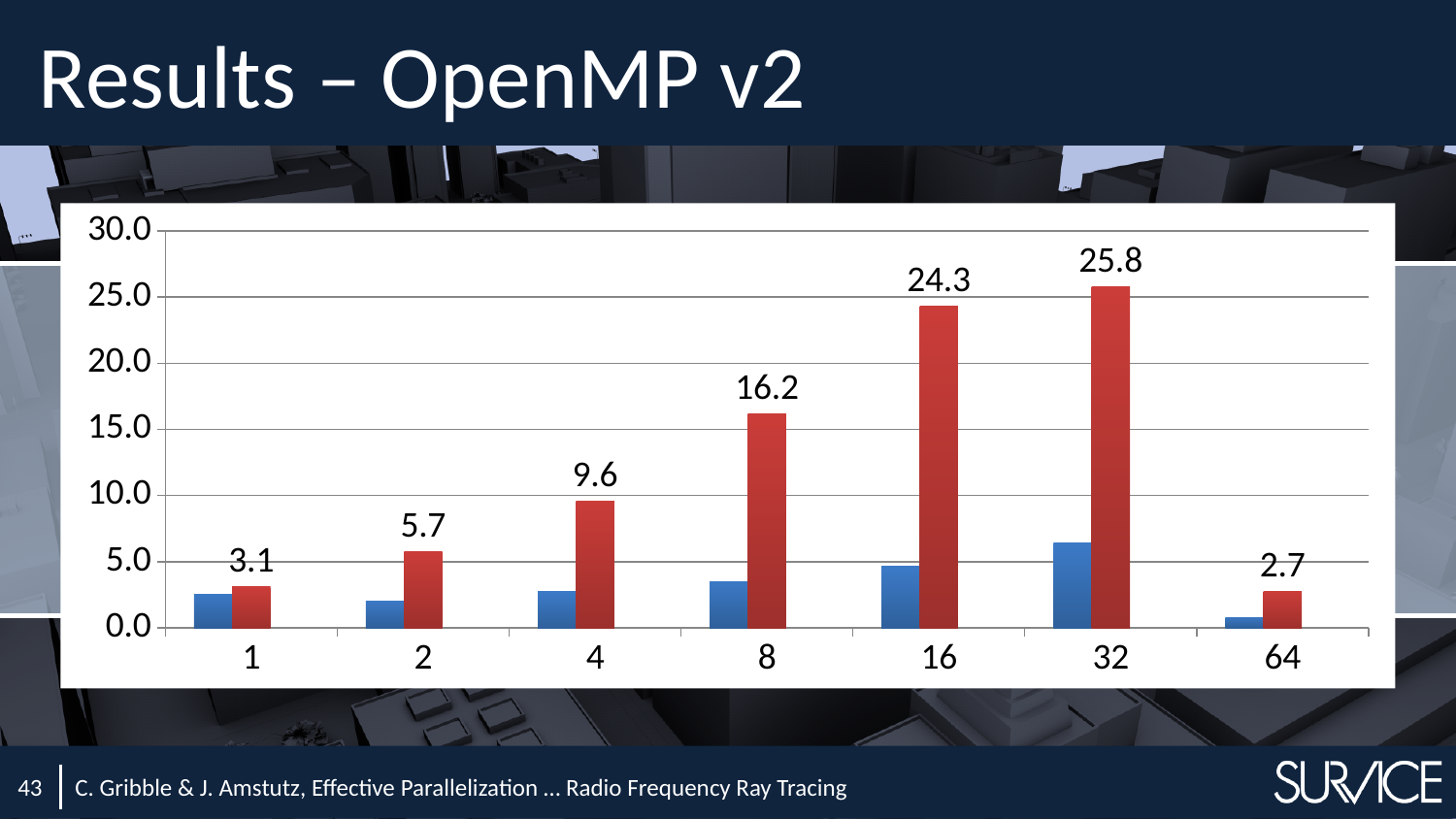
Is the value of the blue bar for category 32 greater or less than 5.0? greater What is the difference between the red bar values for categories 32 and 16? 1.5 What is the value of the red bar for category 8? 16.2 What is the value of the red bar for category 1? 3.1 Is the value of the blue bar for category 64 greater or less than 5.0? less Which has a larger red bar value, category 16 or category 8? 16 What type of chart is shown on the slide? Bar chart What is the difference between the red bar values for categories 8 and 4? 6.6 What is the value of the red bar for category 32? 25.8 Which category has the lowest red bar? 64 Which category has the highest red bar? 32 How many categories are shown on the x axis? 7